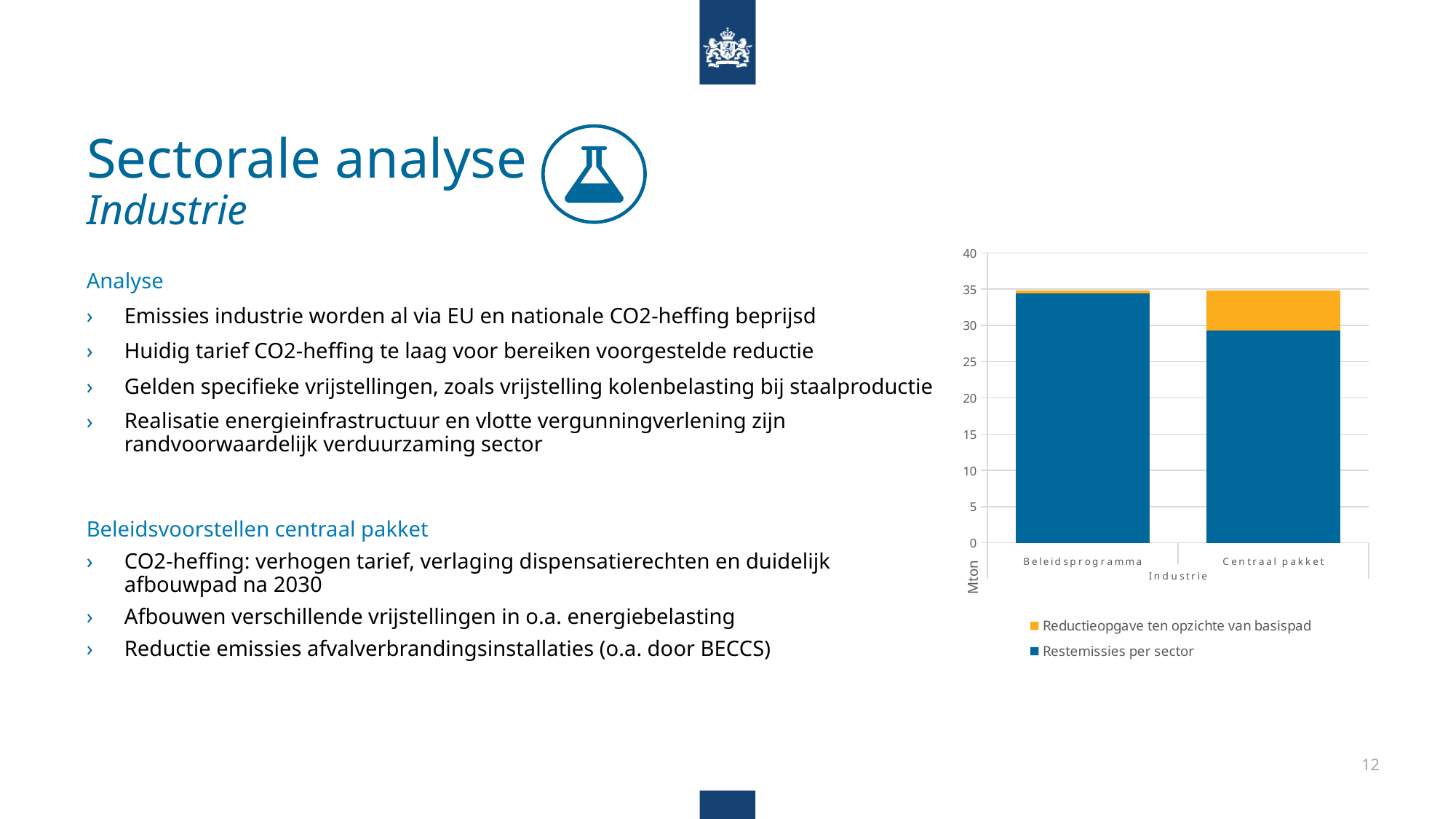
Is the value for Restemissies per sector in Beleidsprogramma greater or less than 30? greater Is the value for Restemissies per sector in Centraal pakket greater or less than 25? greater Which colour represents Reductieopgave ten opzichte van basispad in the chart? orange What unit is shown on the y axis of the chart? Mton Is the value for Reductieopgave ten opzichte van basispad in Centraal pakket greater or less than 10? less What is the group label shown beneath the two categories on the x axis? Industrie Which category has the larger value for Reductieopgave ten opzichte van basispad, Beleidsprogramma or Centraal pakket? Centraal pakket Which category has the larger value for Restemissies per sector, Beleidsprogramma or Centraal pakket? Beleidsprogramma How many series does the chart's legend list? 2 How many categories are shown on the x axis of the chart? 2 What kind of chart is shown on the slide? stacked bar chart